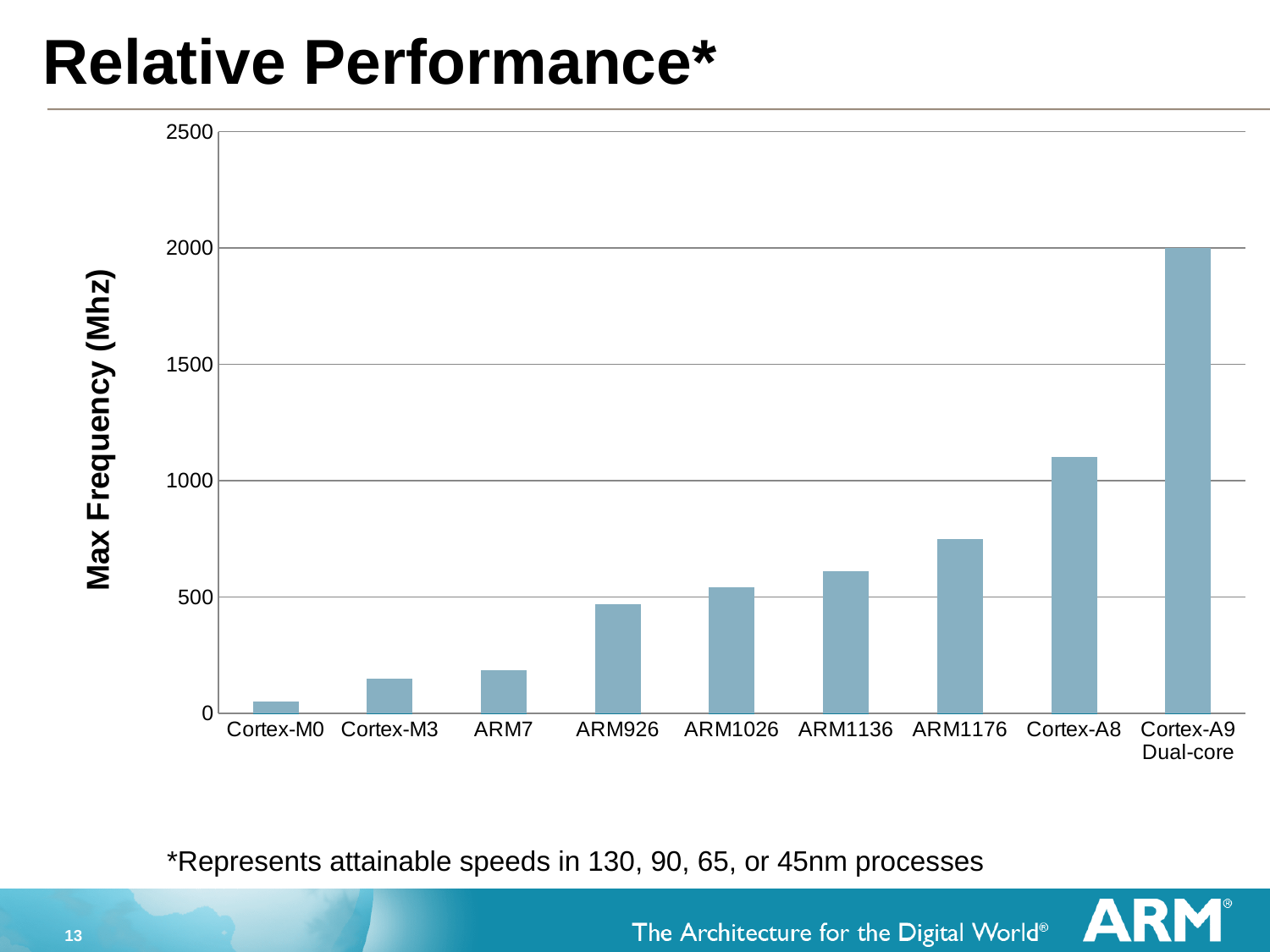
Is the value for ARM926 greater or less than 500? less What kind of chart is shown on the slide? bar chart How many processor categories are plotted on the x axis? 9 Which processor has the lowest max frequency? Cortex-M0 Which has a higher max frequency, Cortex-A8 or ARM1176? Cortex-A8 Is the value for ARM1026 greater or less than 1000? less What is the max frequency shown for Cortex-A9 Dual-core? 2000 Is the value for ARM1176 greater or less than 500? greater Do the values rise or fall moving from left to right along the x axis? rise What is the label on the vertical axis of the chart? Max Frequency (Mhz) Which processor has the highest max frequency? Cortex-A9 Dual-core